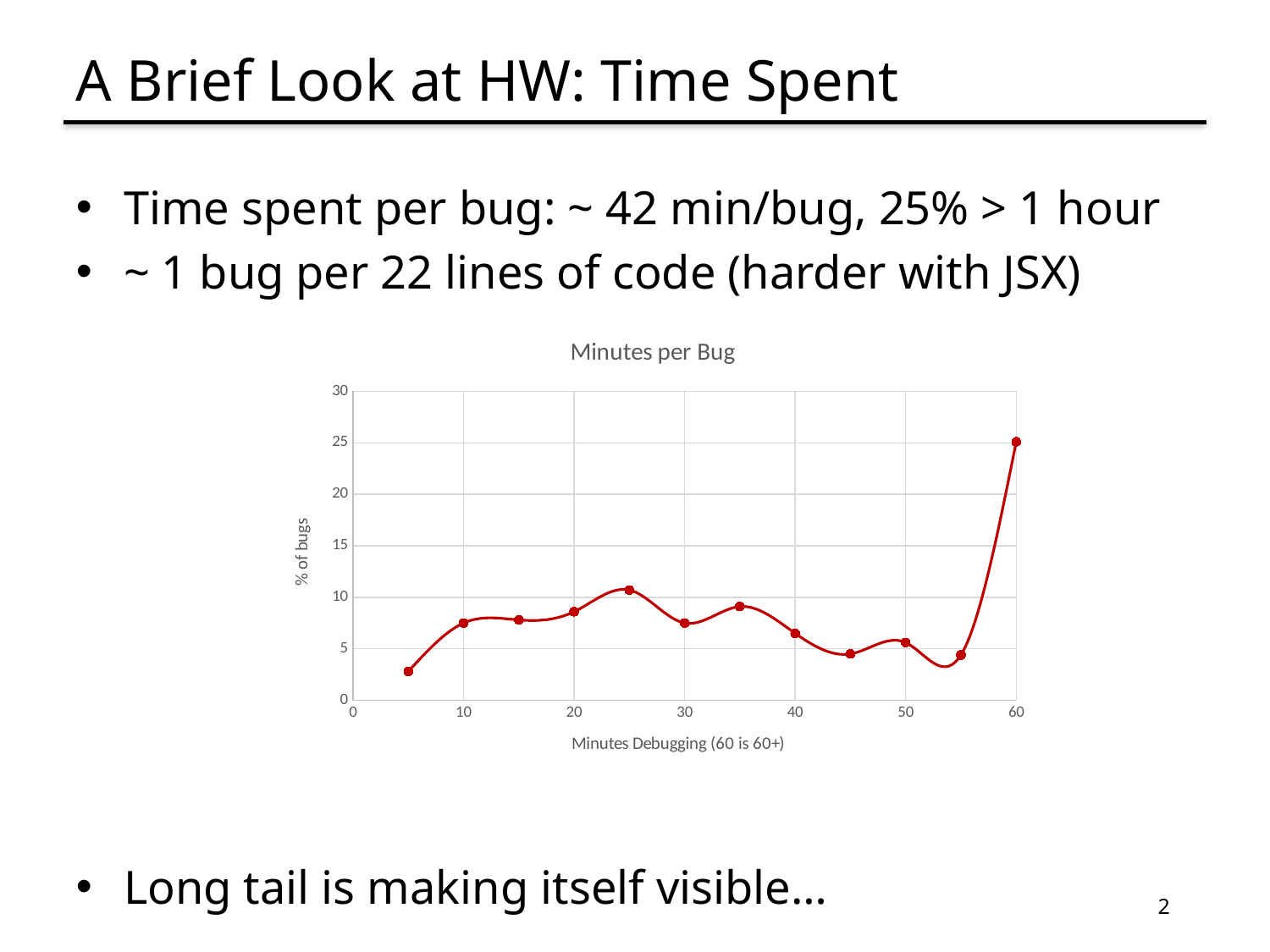
Does the % of bugs rise or fall between 55 and 60 minutes? rise What type of chart is shown on the slide? line chart At which value of Minutes Debugging is the % of bugs highest? 60 At which value of Minutes Debugging is the % of bugs lowest? 5 Is the % of bugs at 60 minutes greater or less than 20? greater What is the label of the vertical axis of the chart? % of bugs Is the % of bugs at 5 minutes greater or less than 5? less How many data points are plotted on the chart? 12 Which has a higher % of bugs: 25 minutes or 30 minutes? 25 minutes Is the % of bugs at 20 minutes greater or less than 5? greater What is the title of the chart? Minutes per Bug